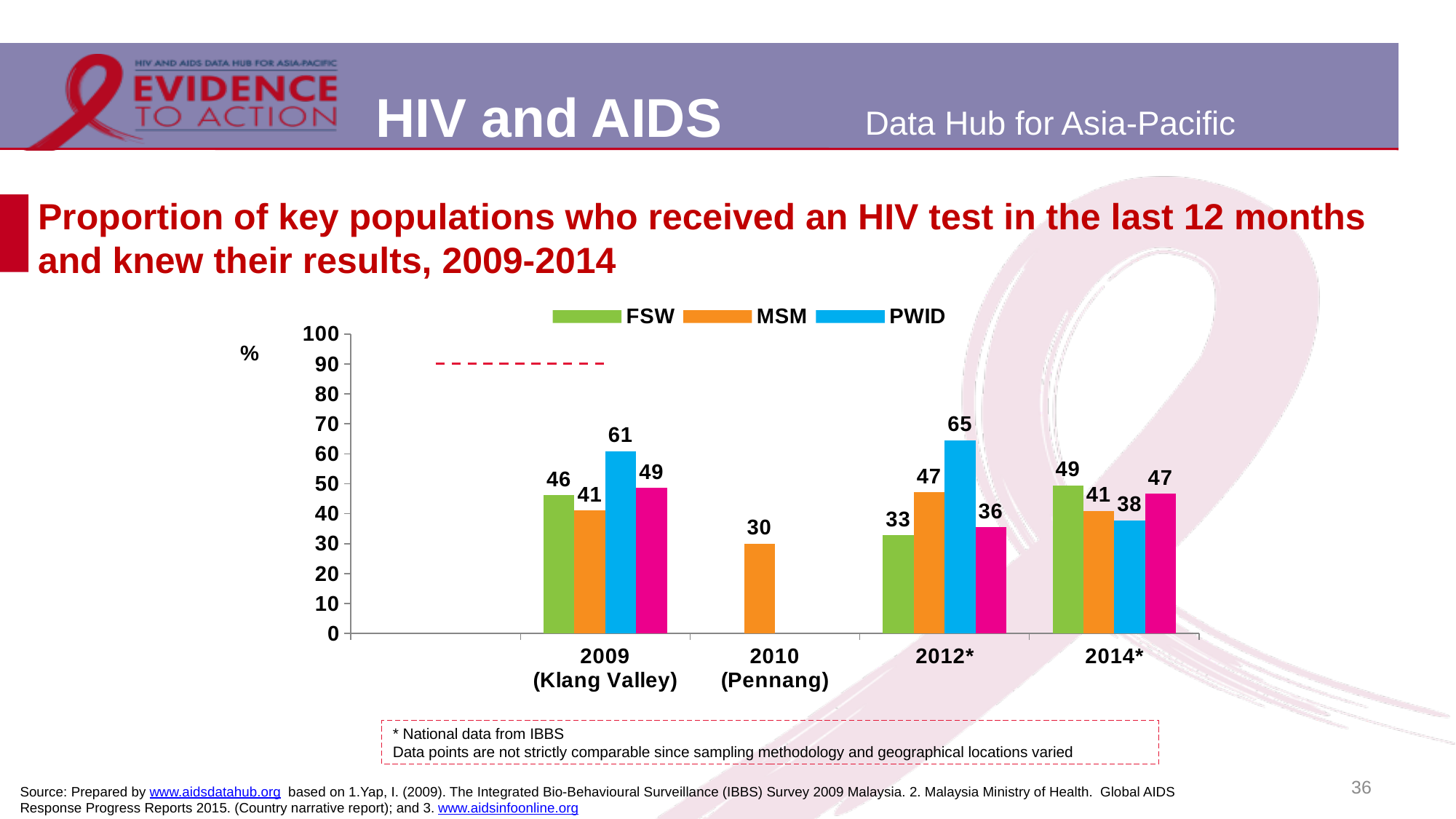
In which year is the PWID value highest? 2012* How many year categories are shown on the x axis? 4 What is the value for MSM in 2010 (Pennang)? 30 What is the difference between the MSM value in 2012* and in 2010 (Pennang)? 17 In which year is the FSW value lowest? 2012* In 2014*, which is larger, the FSW value or the MSM value? FSW What is the value for PWID in 2014*? 38 What is the value for FSW in 2012*? 33 What is the value for PWID in 2009 (Klang Valley)? 61 What kind of chart is shown on the slide? Bar chart How many series does the legend list? 3 What is the difference between the PWID value in 2012* and in 2009 (Klang Valley)? 4